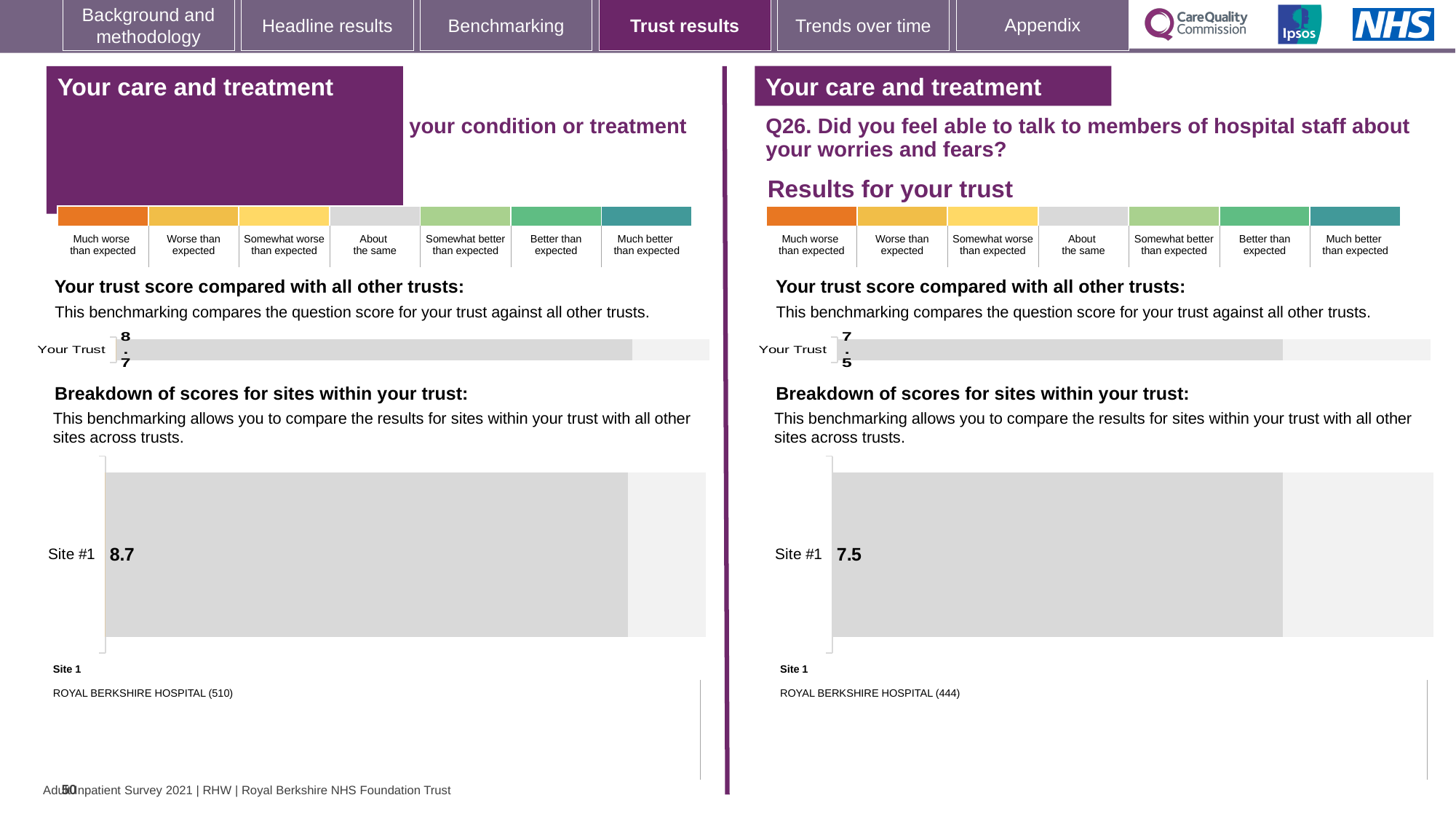
On the left-hand 'Breakdown of scores for sites within your trust' chart, what is the score for Site #1? 8.7 How many sites are shown on the left-hand 'Breakdown of scores for sites within your trust' chart? 1 On the left-hand 'Your trust score compared with all other trusts' chart, what is the score for Your Trust? 8.7 What type of chart is used to show the Site #1 score on the right-hand (Q26) breakdown chart? Bar chart What is the category label on the bar in the left-hand 'Your trust score compared with all other trusts' chart? Your Trust On the right-hand (Q26) 'Your trust score compared with all other trusts' chart, what is the score for Your Trust? 7.5 On the right-hand (Q26) 'Breakdown of scores for sites within your trust' chart, what is the score for Site #1? 7.5 On the left-hand side, is the Site #1 score equal to the Your Trust score? Yes Which hospital is listed as Site 1 beneath the right-hand (Q26) breakdown chart? ROYAL BERKSHIRE HOSPITAL (444) What is the difference between the Site #1 score on the left-hand chart (8.7) and the Site #1 score on the right-hand Q26 chart (7.5)? 1.2 Comparing the Site #1 charts, is the Site #1 score higher on the left-hand chart or on the right-hand (Q26) chart? Left-hand chart